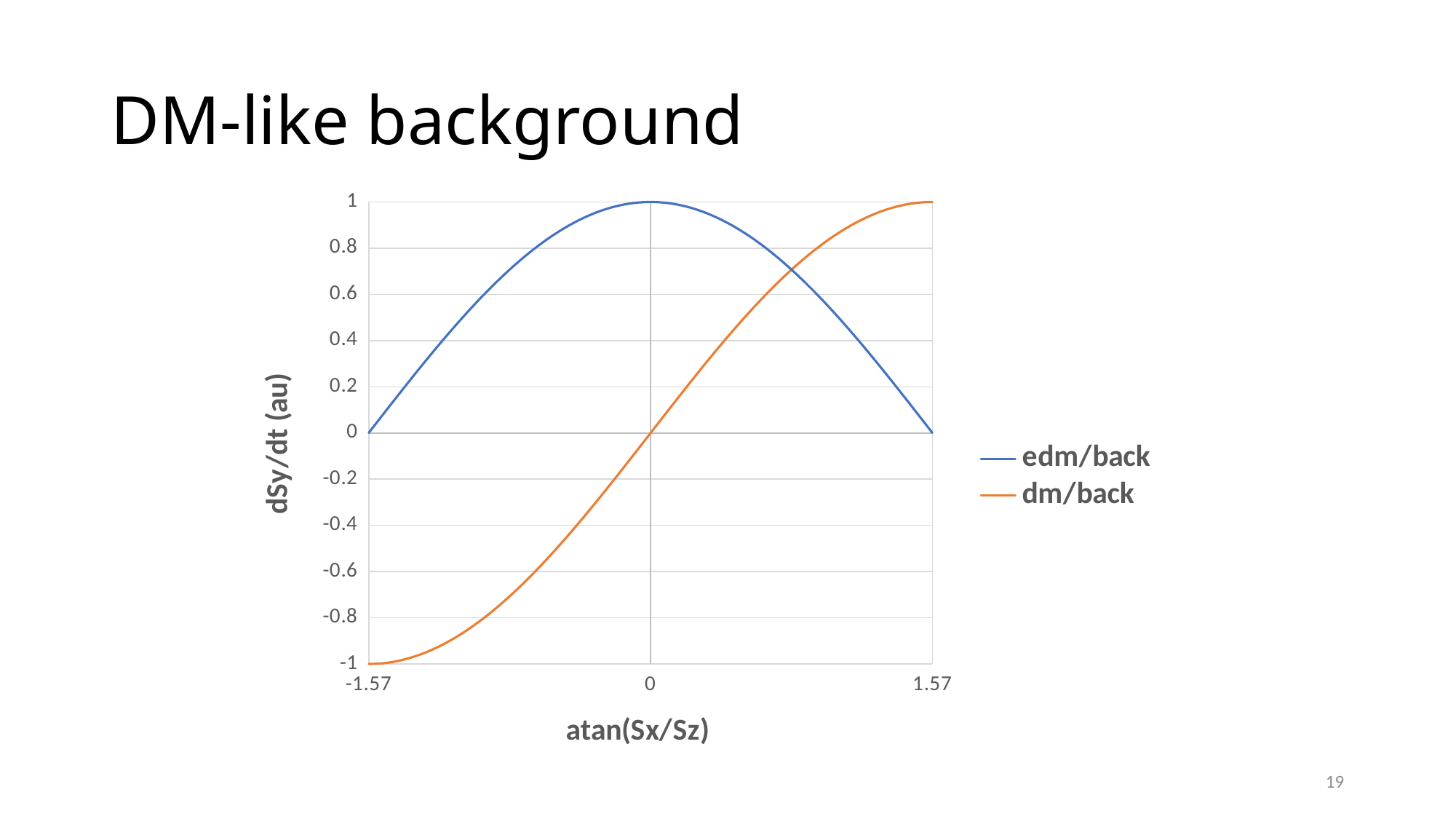
What is the label of the y axis? dSy/dt (au) How many series does the legend list? 2 What kind of chart is shown on the slide? line chart Does the dm/back series rise or fall as atan(Sx/Sz) increases from -1.57 to 1.57? rise What is the value of dm/back at atan(Sx/Sz) = 1.57? 1 Which series has the larger value at atan(Sx/Sz) = 0, edm/back or dm/back? edm/back Is the value of dm/back at atan(Sx/Sz) = -1.57 greater or less than 0? less What is the value of dm/back at atan(Sx/Sz) = 0? 0 What is the value of dm/back at atan(Sx/Sz) = -1.57? -1 What colour is the dm/back line? orange What is the value of edm/back at atan(Sx/Sz) = 1.57? 0 What is the value of edm/back at atan(Sx/Sz) = 0? 1